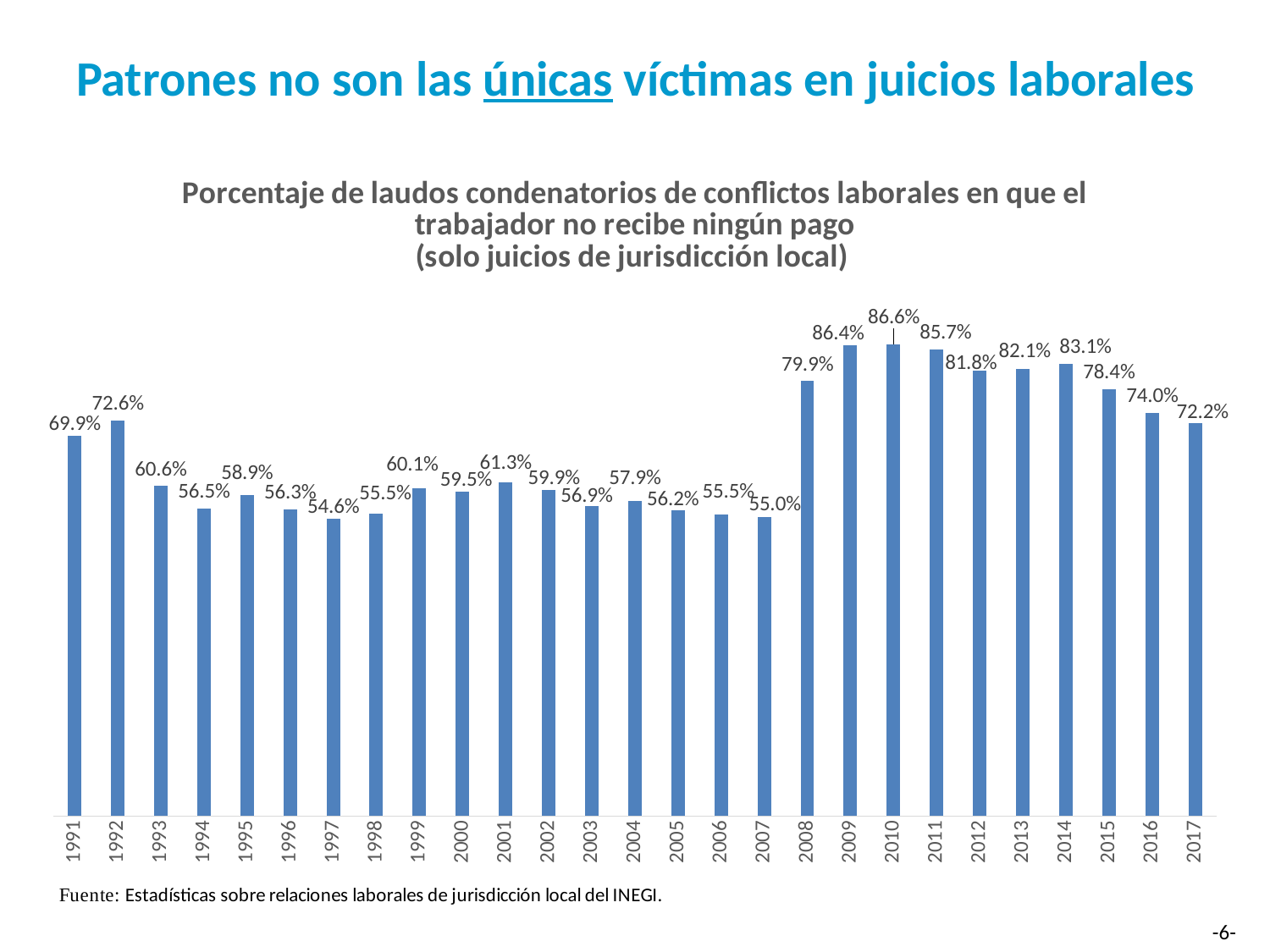
Do the values rise or fall from 2010 to 2017? Fall How many years are shown on the x axis? 27 What is the difference between the values for 2010 and 2009? 0.2% Which is larger, the value for 1992 or the value for 2016? 2016 What is the value for 2017? 72.2% Which year has the lowest value? 1997 What kind of chart is shown on the slide? Bar chart What is the value for 2008? 79.9% Which year has the highest value? 2010 What source is cited below the chart? Estadísticas sobre relaciones laborales de jurisdicción local del INEGI What is the value for 1997? 54.6% What is the difference between the values for 2008 and 2007? 24.9%